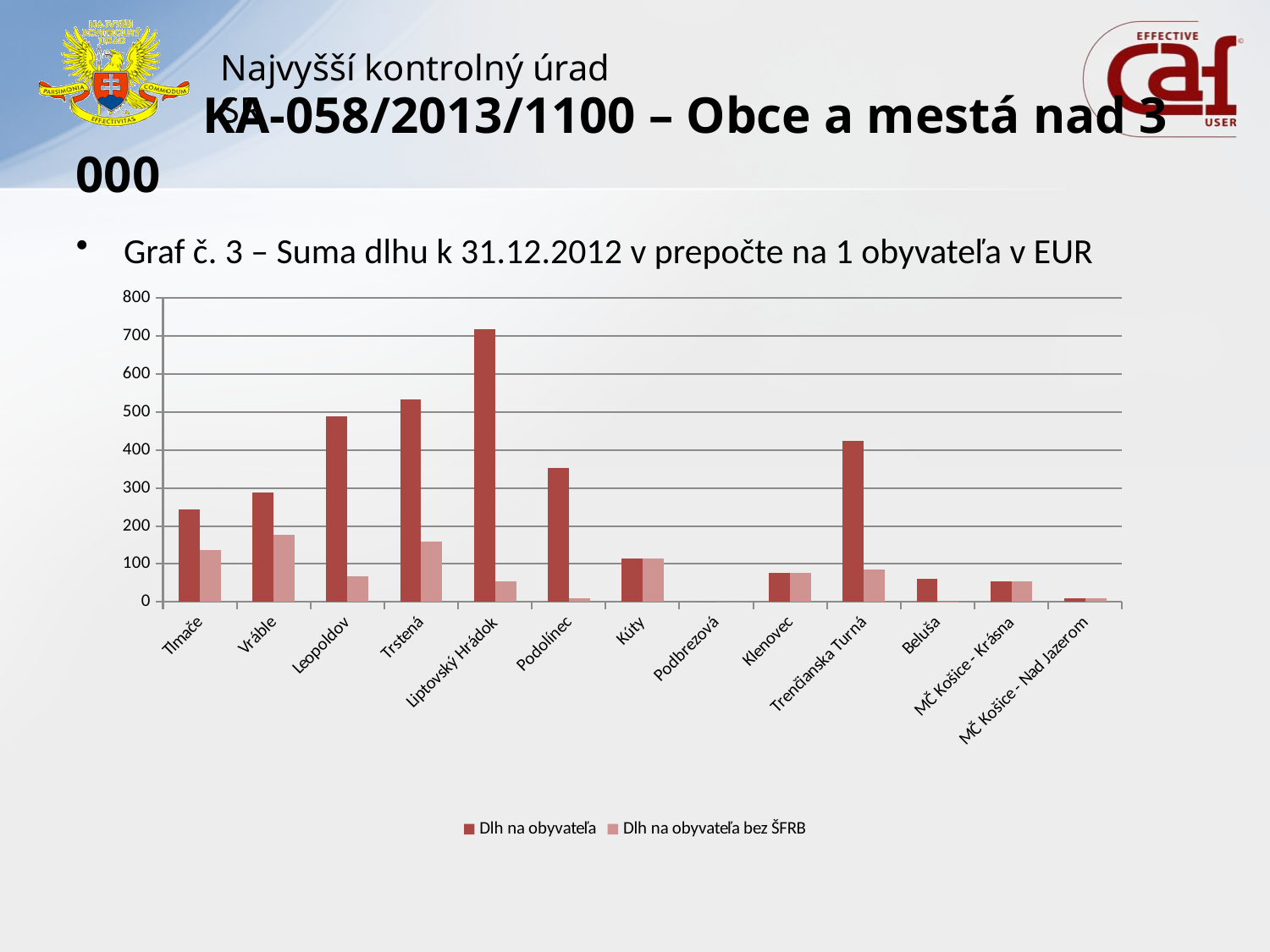
Which is larger for Dlh na obyvateľa: Leopoldov or Podolínec? Leopoldov How many series does the legend list? 2 What type of chart is shown on the slide? bar chart Is the value for Dlh na obyvateľa for Liptovský Hrádok greater or less than 600? greater Is the value for Dlh na obyvateľa for Trenčianska Turná greater or less than 500? less Is the value for Dlh na obyvateľa for Tlmače greater or less than 200? greater Which is larger for Dlh na obyvateľa: Liptovský Hrádok or Trstená? Liptovský Hrádok Which municipality has the highest value for Dlh na obyvateľa? Liptovský Hrádok How many municipalities (categories) are shown on the x axis? 13 What is the name of the second series in the legend? Dlh na obyvateľa bez ŠFRB